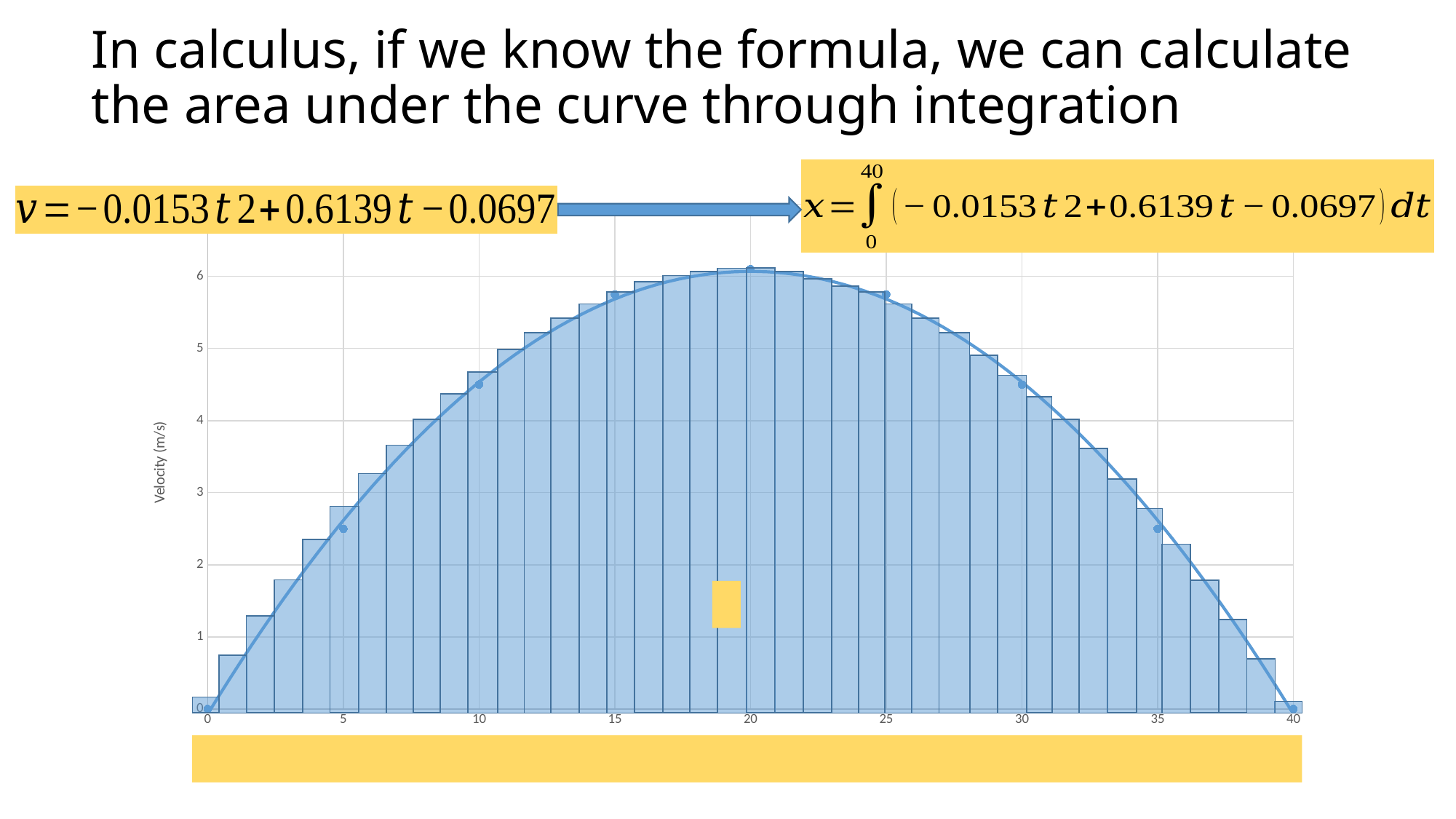
Is the velocity at t = 10 greater or less than 4? greater How does the velocity change as t increases from 0 to 40? It rises to a peak around t = 20, then falls Is the velocity at t = 5 greater or less than 3? less What is the largest value shown on the x axis of the chart? 40 What is the label on the vertical axis of the chart? Velocity (m/s) Is the velocity at t = 5 greater or less than 2? greater At which x-axis value does the plotted curve reach its highest point? 20 Which has the higher velocity, t = 20 or t = 30? t = 20 Which has the higher velocity, t = 10 or t = 5? t = 10